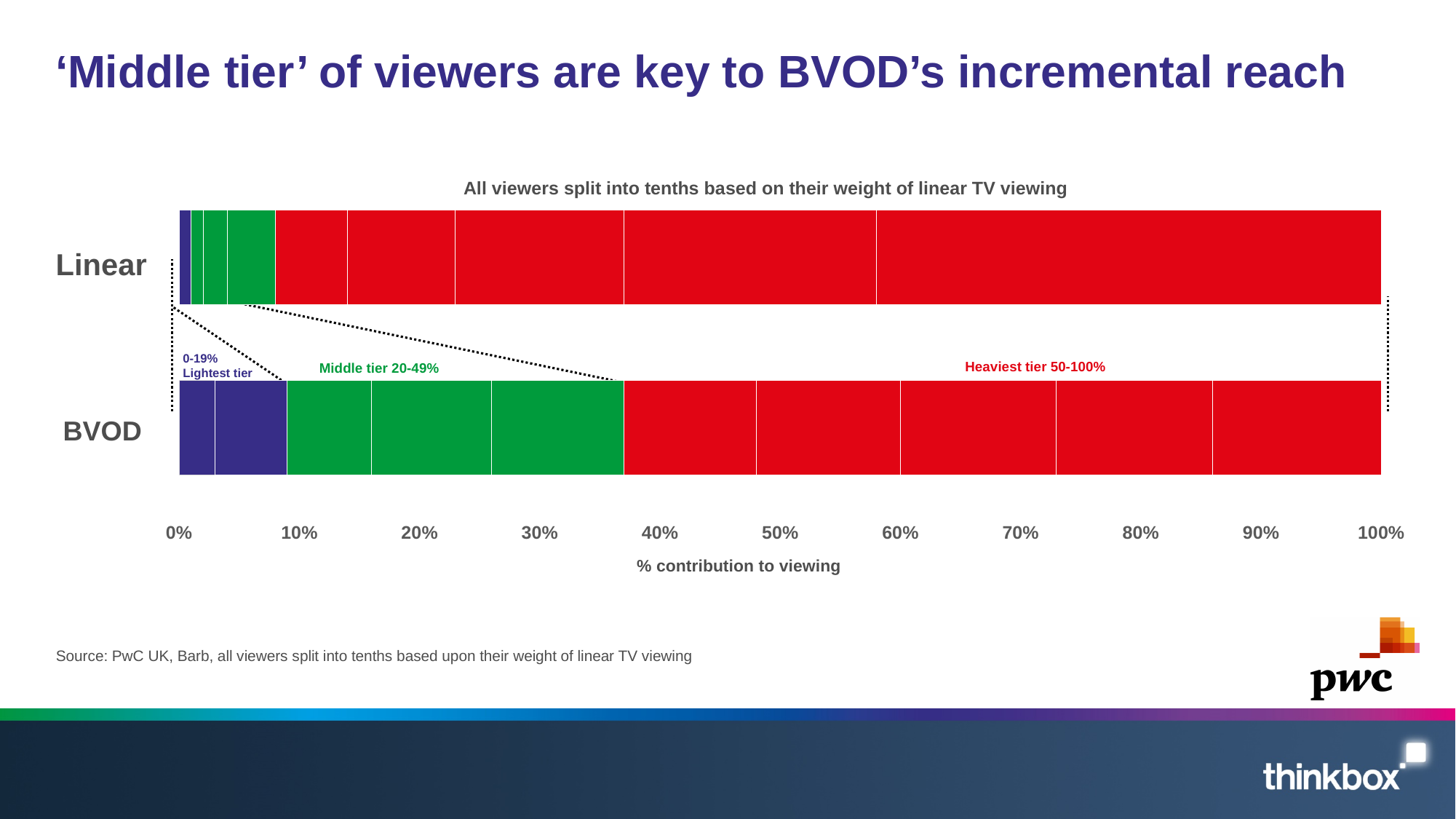
How many bars (categories) does the chart show? 2 What kind of chart is shown on the slide? Stacked bar chart Is the combined contribution of the lightest and middle tiers in the BVOD bar greater or less than 30%? greater Is the combined contribution of the lightest and middle tiers in the BVOD bar greater or less than 40%? less Which bar has the larger contribution to viewing from the heaviest tier (50-100%), Linear or BVOD? Linear What is the title of the chart? All viewers split into tenths based on their weight of linear TV viewing Is the contribution of the heaviest tier (50-100%) in the BVOD bar greater or less than 70%? less What is the label of the horizontal axis? % contribution to viewing Which bar has the larger contribution to viewing from the middle tier (20-49%), Linear or BVOD? BVOD What are the two categories plotted on the chart? Linear and BVOD